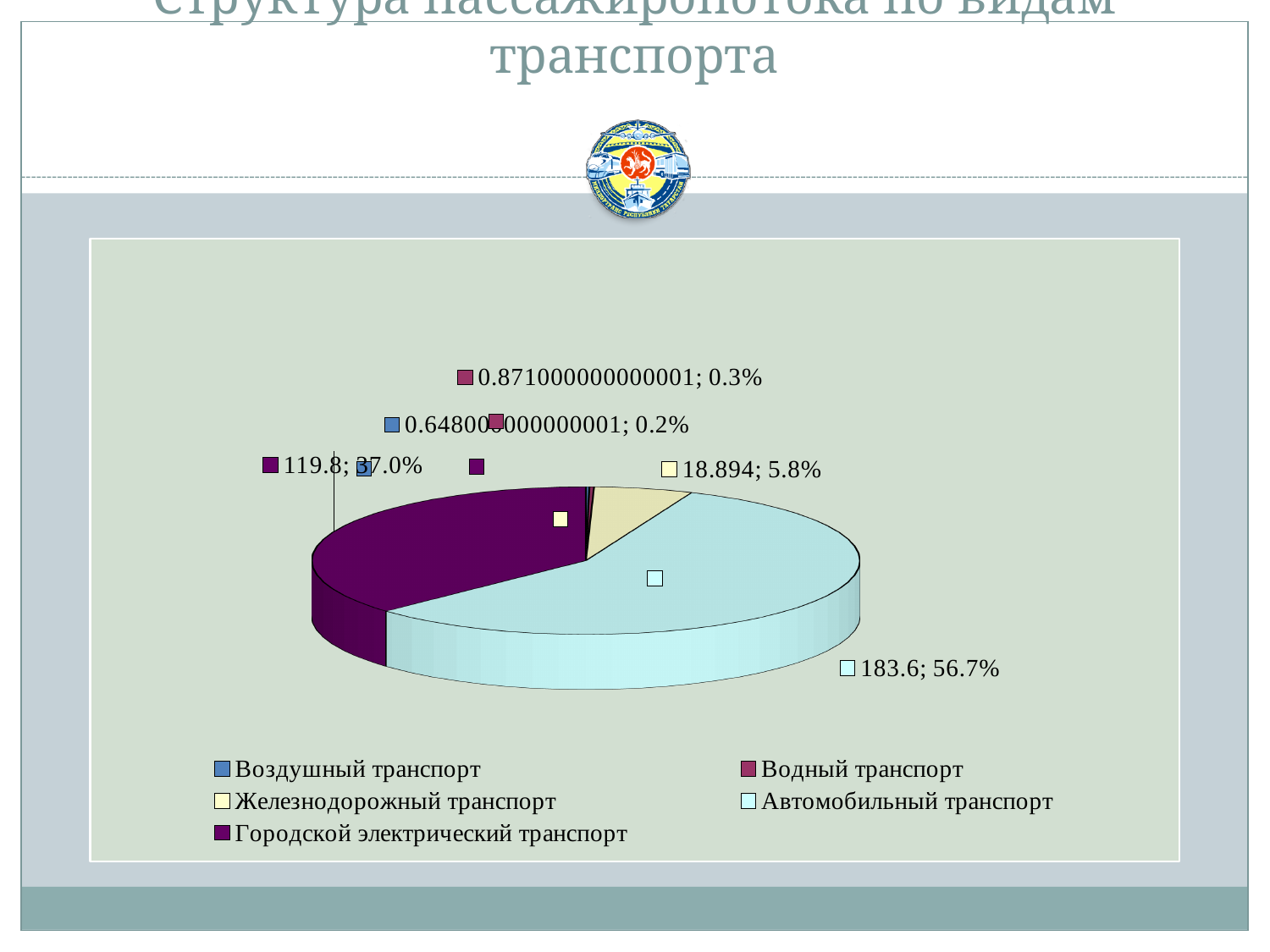
How many categories does the legend of the pie chart list? 5 What value is shown for Железнодорожный транспорт? 18.894 What share of the pie does Автомобильный транспорт have? 56.7% Which is larger, the value for Автомобильный транспорт or the value for Городской электрический транспорт? Автомобильный транспорт Which legend entry is shown in light yellow? Железнодорожный транспорт What value is shown for Автомобильный транспорт? 183.6 What share of the pie does Городской электрический транспорт have? 37.0% Which category has the largest slice of the pie chart? Автомобильный транспорт What kind of chart is shown on the slide? Pie chart What share of the pie does Водный транспорт have? 0.3% What is the difference between the values for Автомобильный транспорт and Городской электрический транспорт? 63.8 What value is shown for Городской электрический транспорт? 119.8